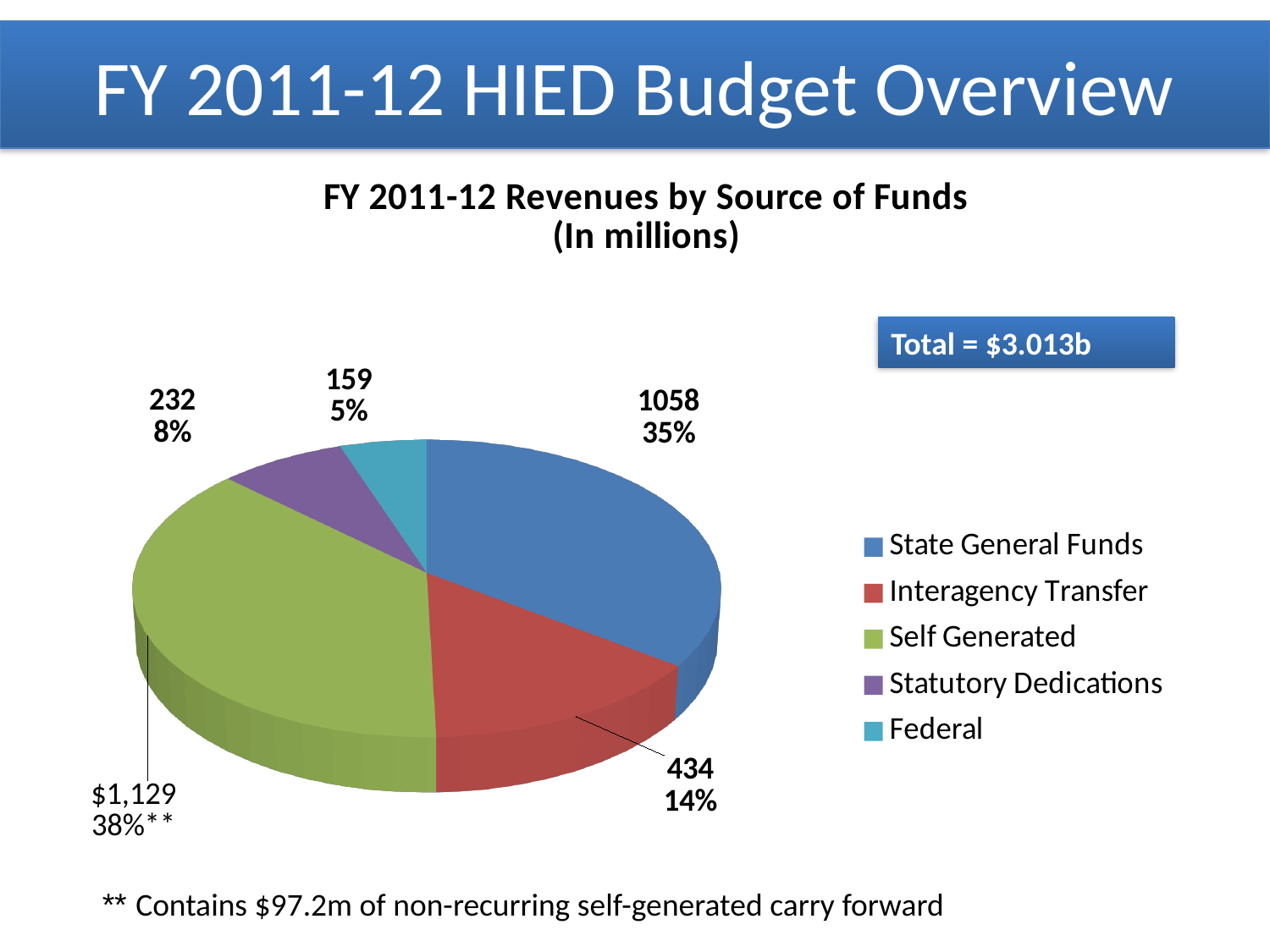
What is the value for Federal? 159 What is the value for Statutory Dedications? 232 What share of the pie does State General Funds represent? 35% What is the title of the chart? FY 2011-12 Revenues by Source of Funds (In millions) Which source of funds has the smallest slice? Federal What is the value for State General Funds? 1058 What share of the pie does Self Generated represent? 38% Which source of funds has the largest slice? Self Generated What is the difference between the values for Interagency Transfer and Statutory Dedications? 202 What type of chart is shown on the slide? pie chart What is the value for Interagency Transfer? 434 How many categories does the legend list? 5